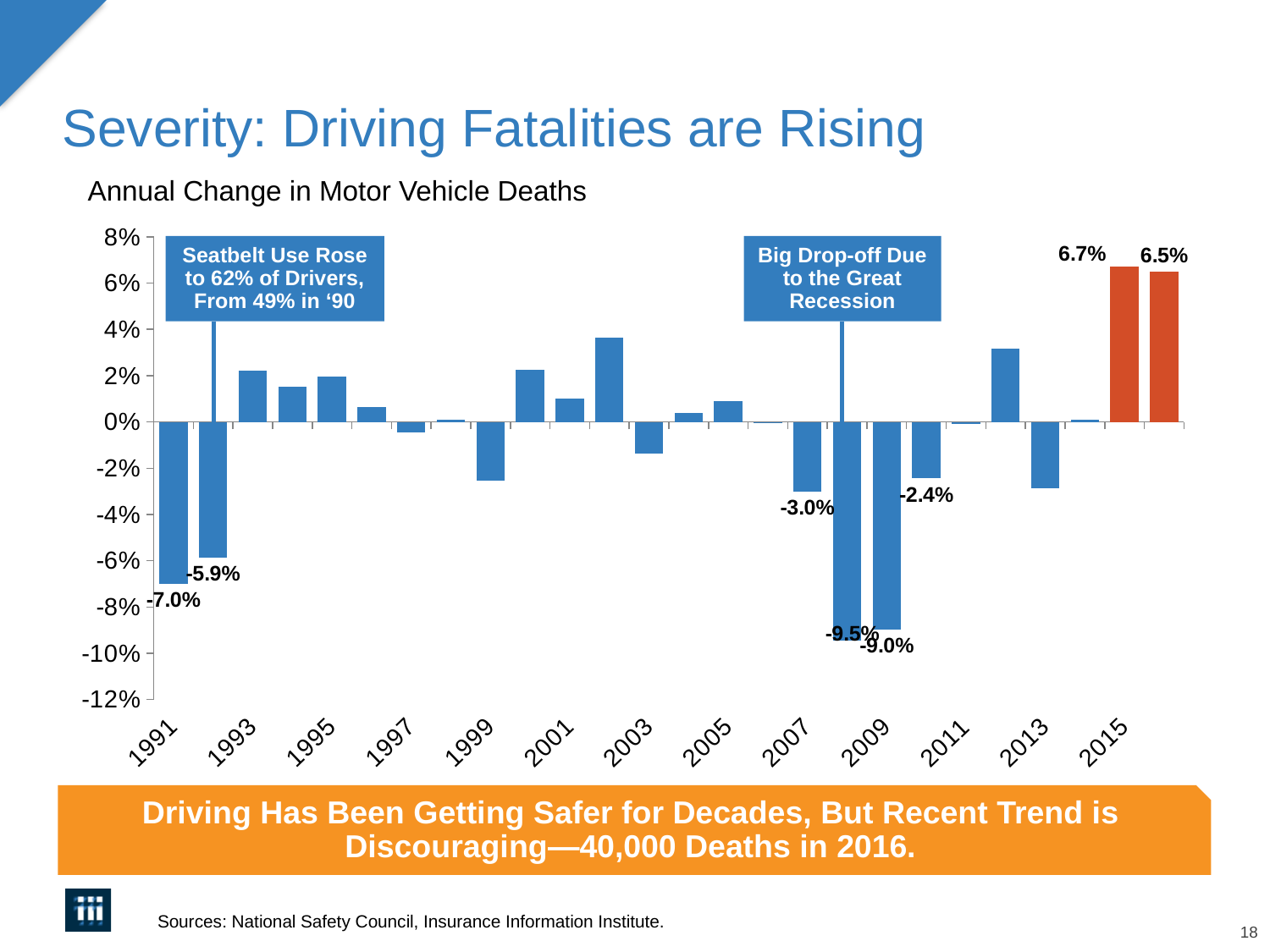
What is the annual change in motor vehicle deaths shown for 1991? -7.0% Which year has the lowest annual change in motor vehicle deaths? 2008 What is the difference between the 2008 and 2009 values, in percentage points? 0.5 percentage points By how many percentage points does the 2015 value exceed the 2016 value? 0.2 percentage points What value is labeled on the bar for 2015? 6.7% What is the annual change in motor vehicle deaths shown for 2008? -9.5% What type of chart is used on this slide? Bar chart Which year shows a larger decline in motor vehicle deaths, 1991 or 1992? 1991 Is the value for 2002 greater or less than 2%? greater What colour are the bars for 2015 and 2016? Orange What value is labeled on the bar for 2010? -2.4% Which year has the highest annual change in motor vehicle deaths? 2015